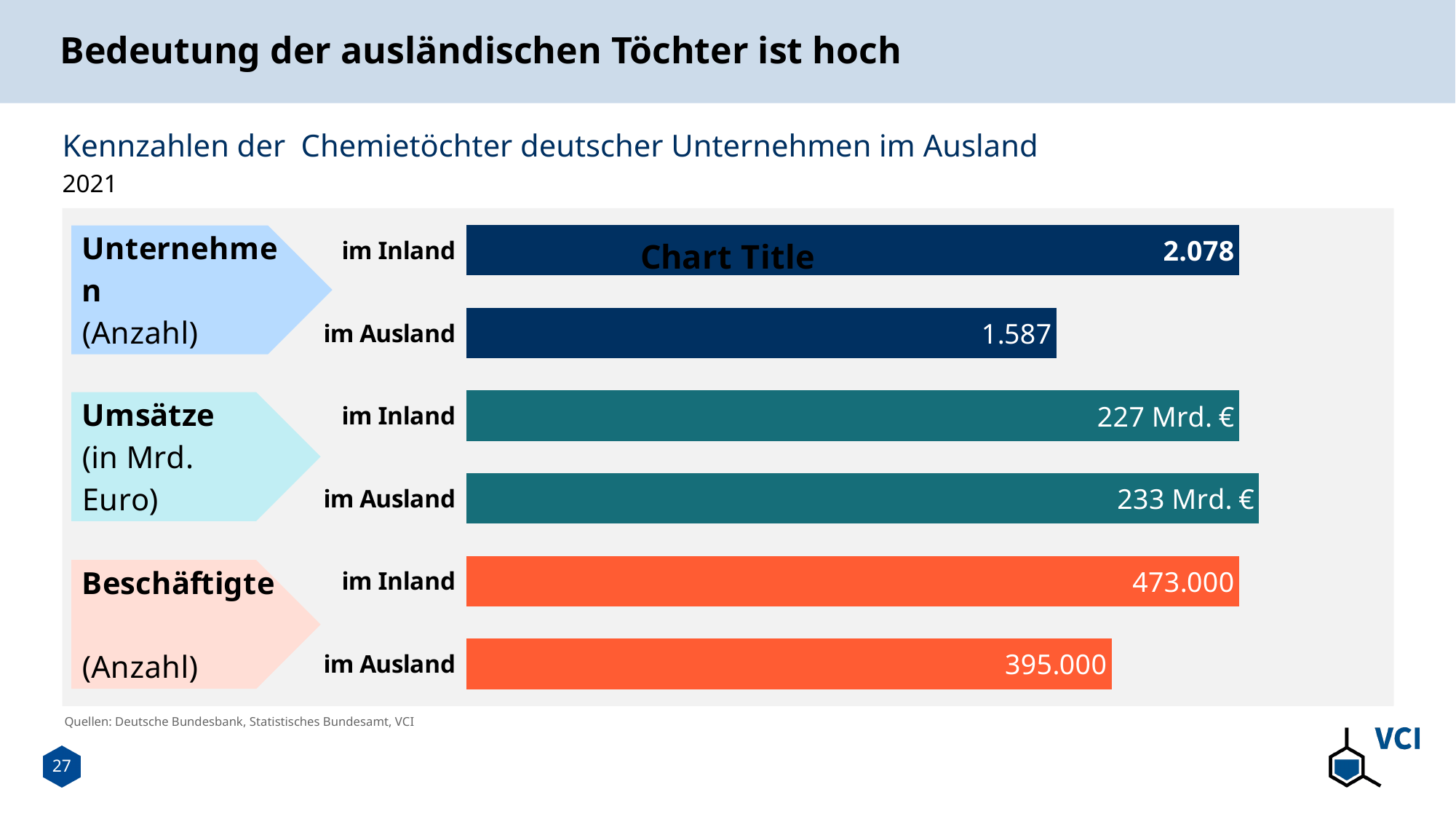
What is the difference between the number of Unternehmen im Inland and im Ausland? 491 What value is shown for Umsätze im Ausland? 233 Mrd. € What is the number of Unternehmen im Ausland shown on the chart? 1.587 What value is shown for Umsätze im Inland? 227 Mrd. € What is the difference between Beschäftigte im Inland and im Ausland? 78.000 How many bars are plotted on the chart? 6 How many Beschäftigte im Ausland does the chart show? 395.000 What is the number of Unternehmen im Inland shown on the chart? 2.078 Which is larger for Beschäftigte: im Inland or im Ausland? im Inland What kind of chart is shown on the slide? Bar chart How many Beschäftigte im Inland does the chart show? 473.000 Which is larger for Umsätze: im Inland or im Ausland? im Ausland